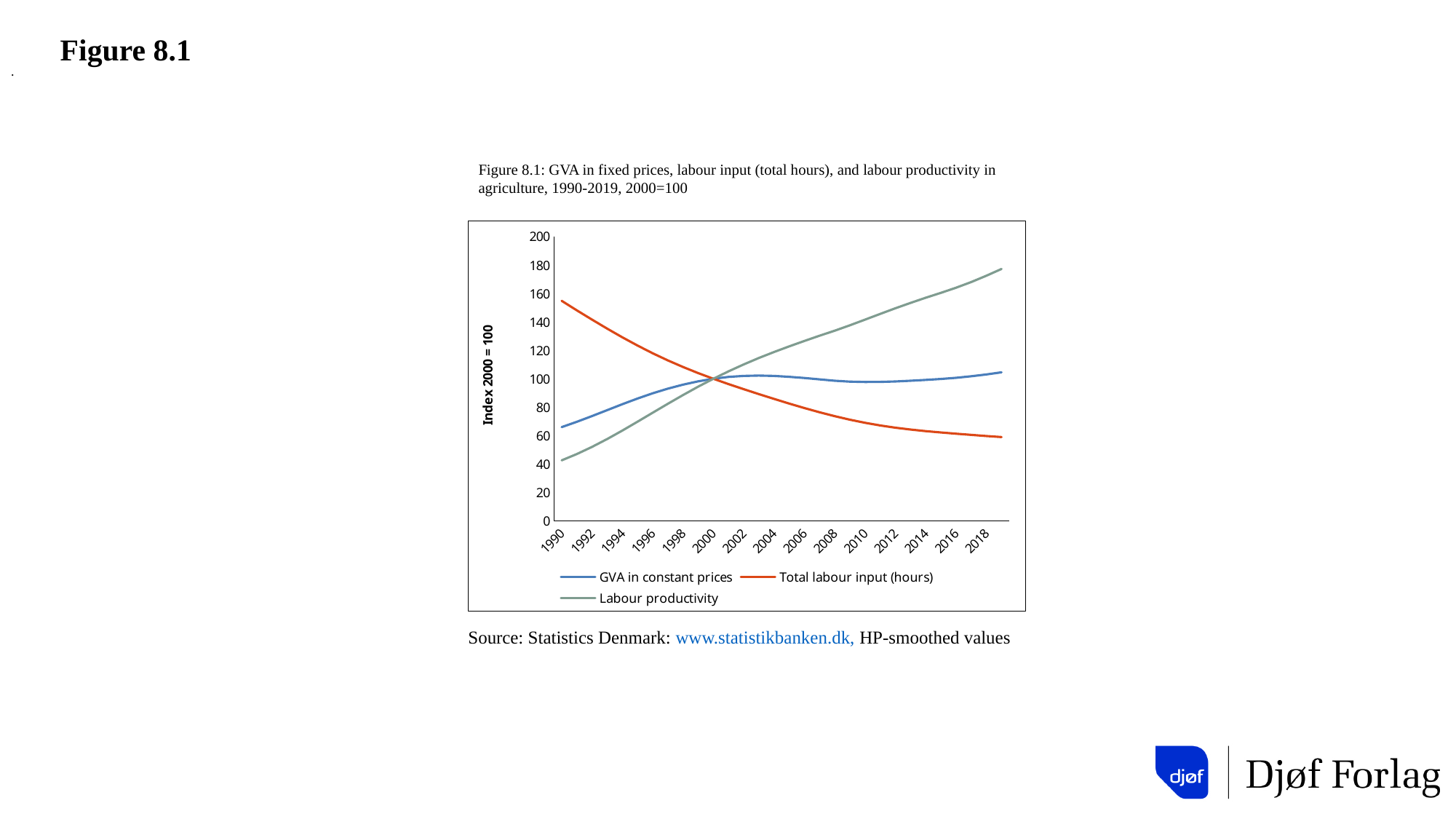
In 1990, which is larger: Total labour input (hours) or GVA in constant prices? Total labour input (hours) What kind of chart is shown on the slide? Line chart Is the value for Total labour input (hours) in 1990 greater or less than 140? greater Does the Labour productivity series rise or fall from 1990 to 2018? Rise How many series does the legend list? 3 Which series has the highest value in 2018? Labour productivity Is the value for Labour productivity in 1990 greater or less than 60? less Does the Total labour input (hours) series rise or fall from 1990 to 2018? Fall Is the value for Labour productivity in 2018 greater or less than 160? greater What is the title of the vertical axis? Index 2000 = 100 Which series has the lowest value in 1990? Labour productivity